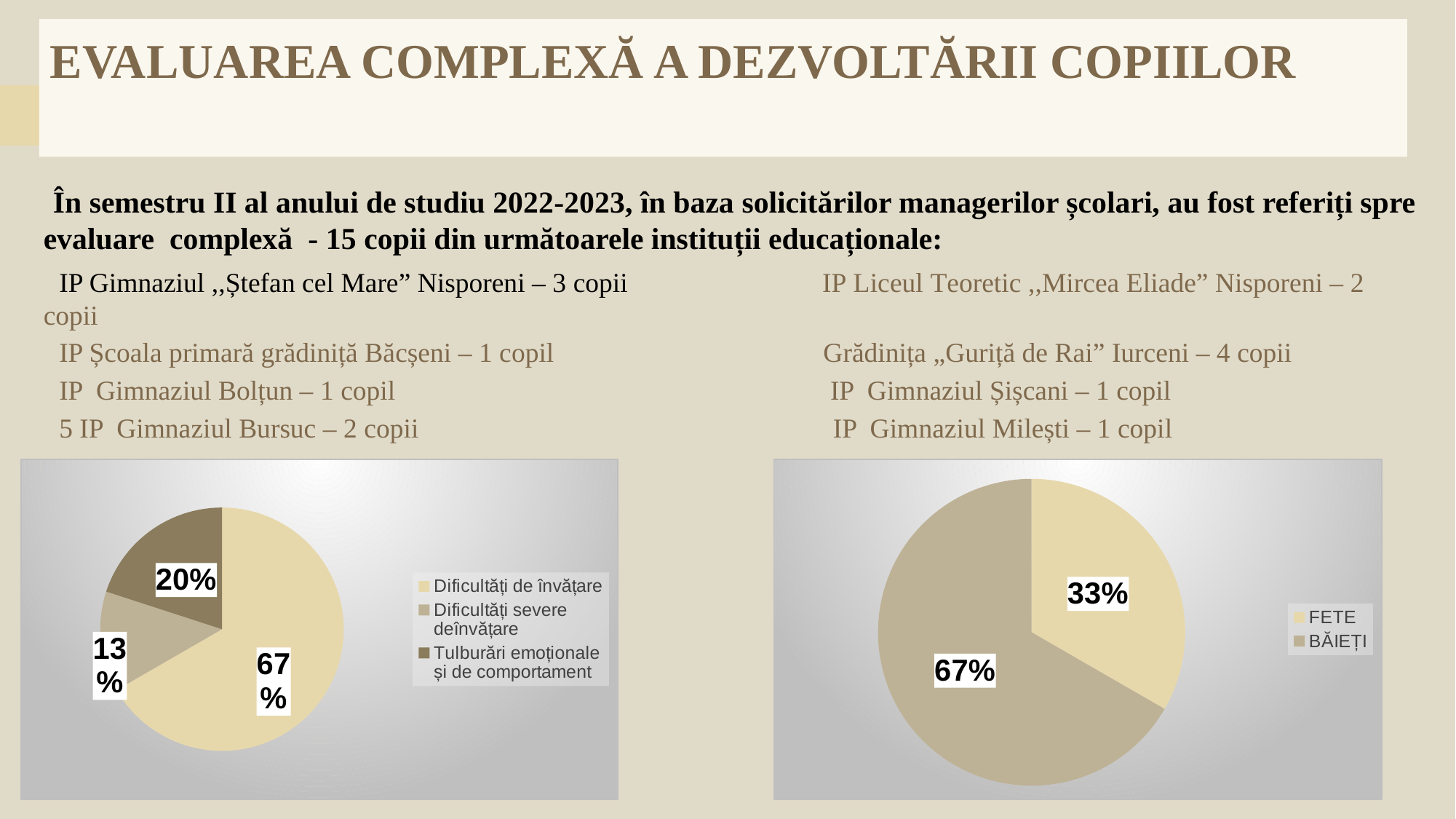
What kind of chart is the right chart on the slide? pie chart In the right pie chart, which slice is larger, FETE or BĂIEȚI? BĂIEȚI In the left pie chart, what share is labelled for Tulburări emoționale și de comportament? 20% In the right pie chart, what share is labelled for BĂIEȚI? 67% In the left pie chart, what share is labelled for Dificultăți severe de învățare? 13% In the left pie chart, which category has the largest slice? Dificultăți de învățare In the left pie chart, how many categories does the legend list? 3 In the left pie chart, which category has the smallest slice? Dificultăți severe de învățare In the right pie chart, what is the difference between the BĂIEȚI share and the FETE share? 34% What kind of chart is the left chart on the slide? pie chart